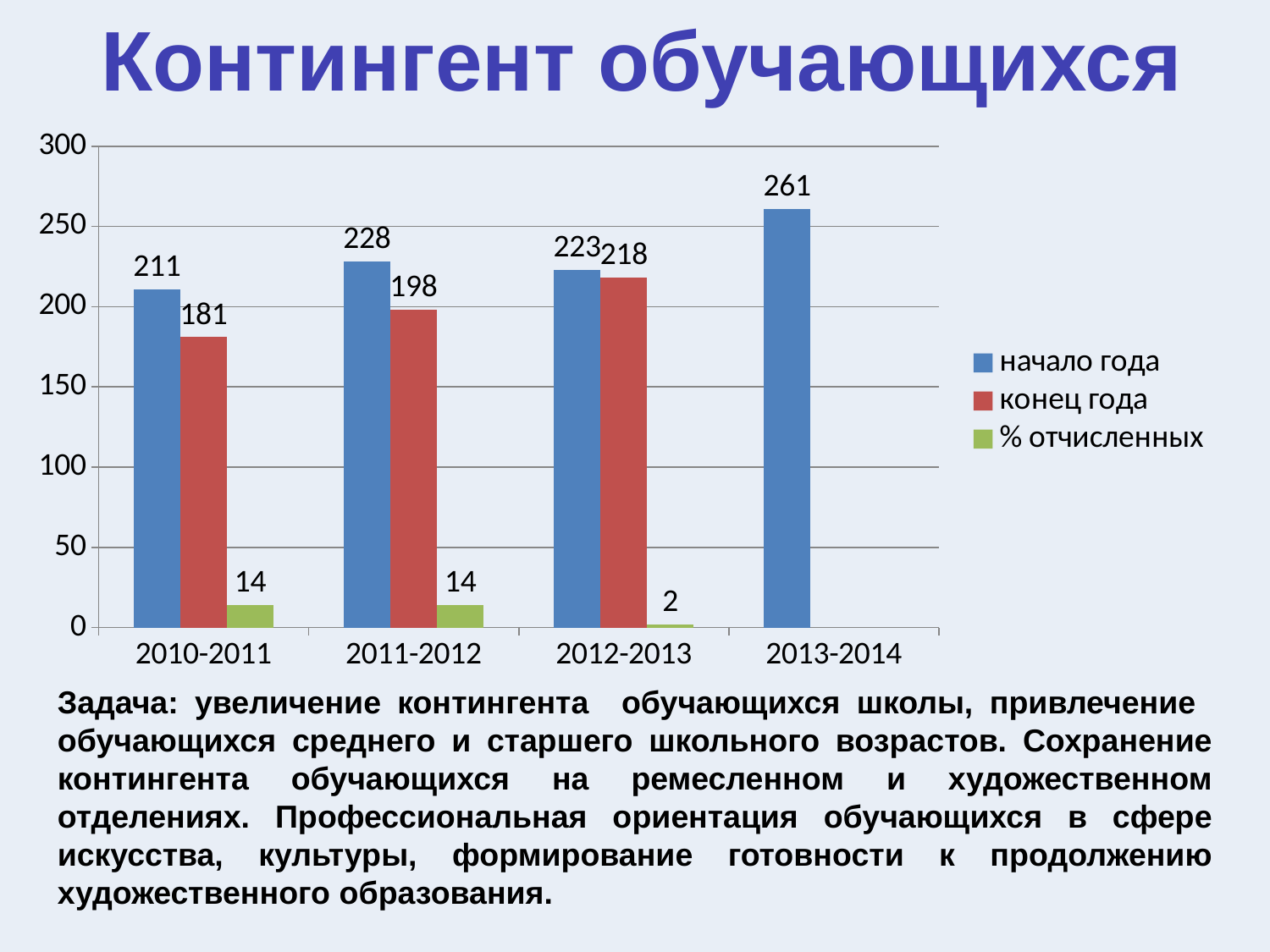
What kind of chart is shown on the slide? bar chart What is the value of 'начало года' for 2013-2014? 261 Which year has the lowest value for 'конец года'? 2010-2011 What is the value of '% отчисленных' for 2012-2013? 2 What is the title of the slide? Контингент обучающихся What is the value of 'конец года' for 2010-2011? 181 Which year has the highest value for 'начало года'? 2013-2014 Is the value of 'начало года' for 2013-2014 greater or less than 250? greater Which is larger: 'начало года' in 2012-2013 or 'начало года' in 2011-2012? 2011-2012 How many year categories are shown on the x axis? 4 How many series does the legend list? 3 What is the difference between 'начало года' and 'конец года' in 2011-2012? 30